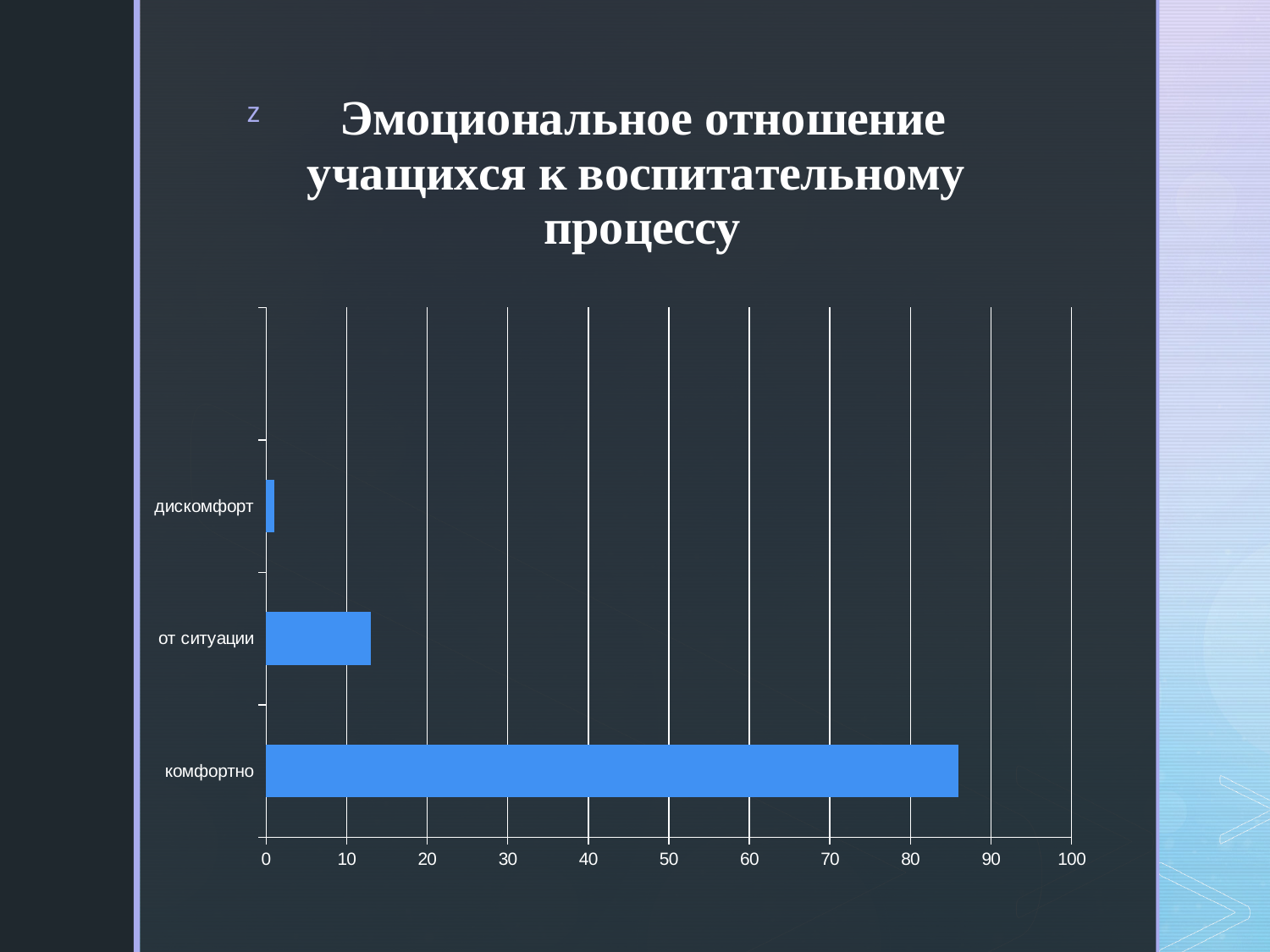
What is the title of the chart on the slide? Эмоциональное отношение учащихся к воспитательному процессу Which category has the lowest value? дискомфорт Is the value for "комфортно" greater or less than 80? greater Which category has the highest value? комфортно Is the value for "комфортно" greater or less than 90? less Is the value for "дискомфорт" greater or less than 10? less Which is larger, the value for "от ситуации" or the value for "дискомфорт"? от ситуации Which is larger, the value for "комфортно" or the value for "от ситуации"? комфортно How many categories are plotted in the chart? 3 What kind of chart is shown on the slide? bar chart